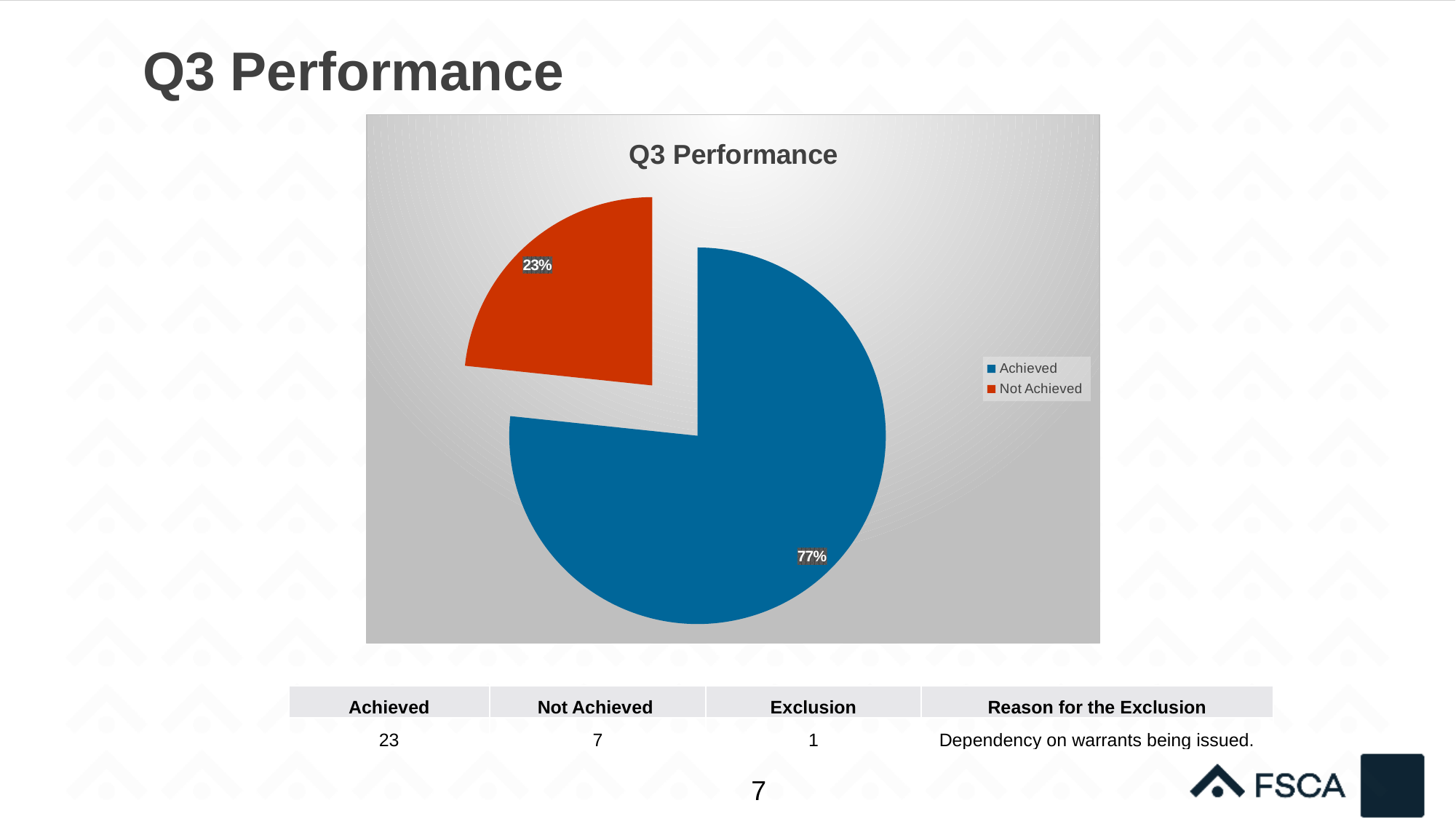
What is the difference in percentage points between the Achieved and Not Achieved slices? 54 How many slices does the pie chart have? 2 Which slice of the pie is the smallest? Not Achieved What colour is the Not Achieved slice? red Which is larger, the Achieved slice or the Not Achieved slice? Achieved What type of chart is shown on the slide? pie chart What percentage of the pie is labelled Not Achieved? 23% What is the title of the chart? Q3 Performance Which slice of the pie is the largest? Achieved How many entries does the legend list? 2 Is the Achieved share greater or less than 50%? greater What percentage of the pie is labelled Achieved? 77%